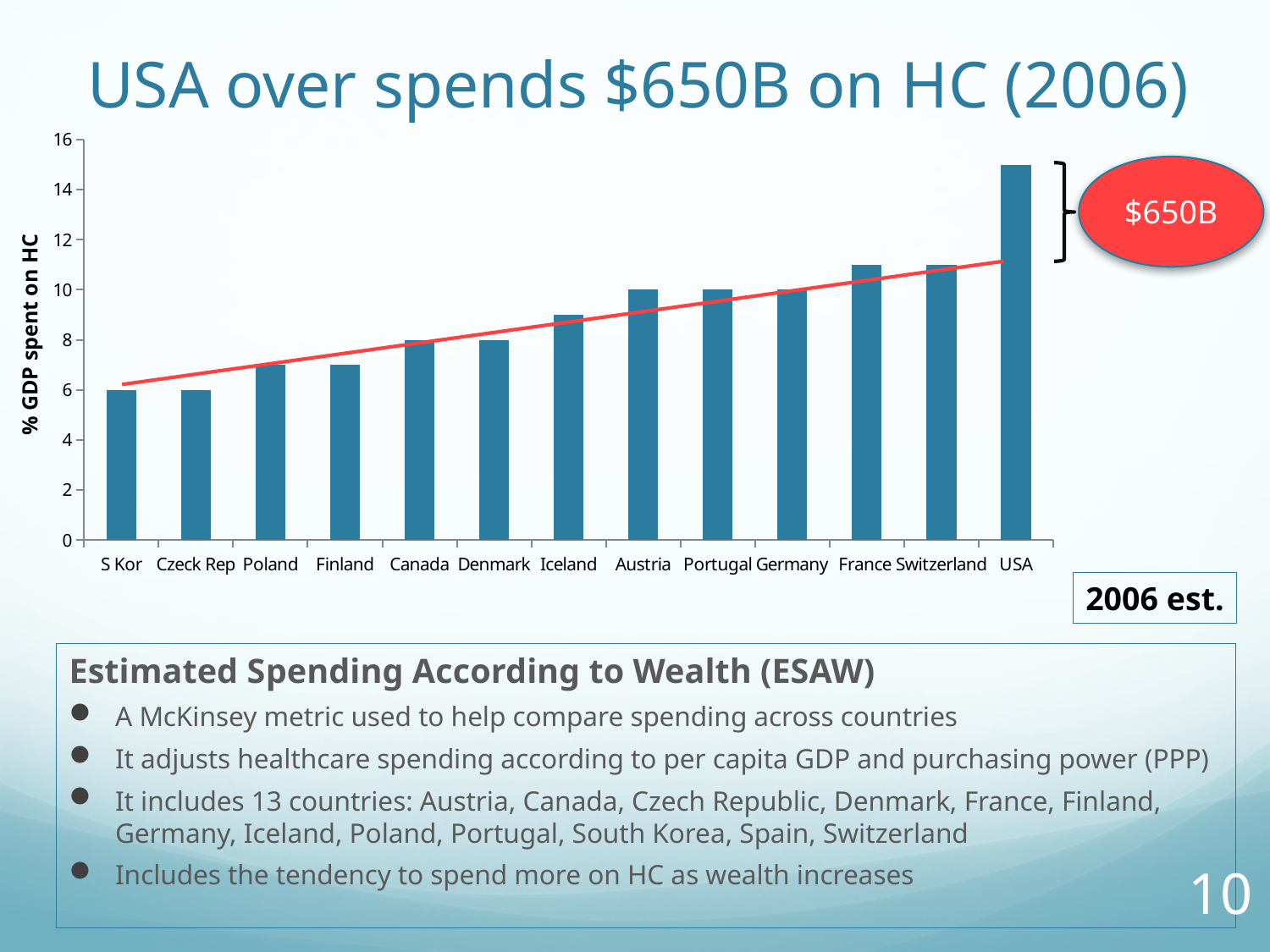
Is the value for France greater or less than 10? greater Which has a larger % GDP spent on HC, USA or Switzerland? USA Which country has the highest % GDP spent on HC in the chart? USA What is the % GDP spent on HC for S Kor? 6 What is the % GDP spent on HC for Austria? 10 Is the value for USA greater or less than 14? greater Is the value for Poland greater or less than 8? less How many countries are shown on the x axis of the chart? 13 What is the difference in % GDP spent on HC between Germany and Czeck Rep? 4 What kind of chart is shown on the slide? bar chart Do the bar values generally rise or fall from left to right along the x axis? rise What is the % GDP spent on HC for Canada? 8